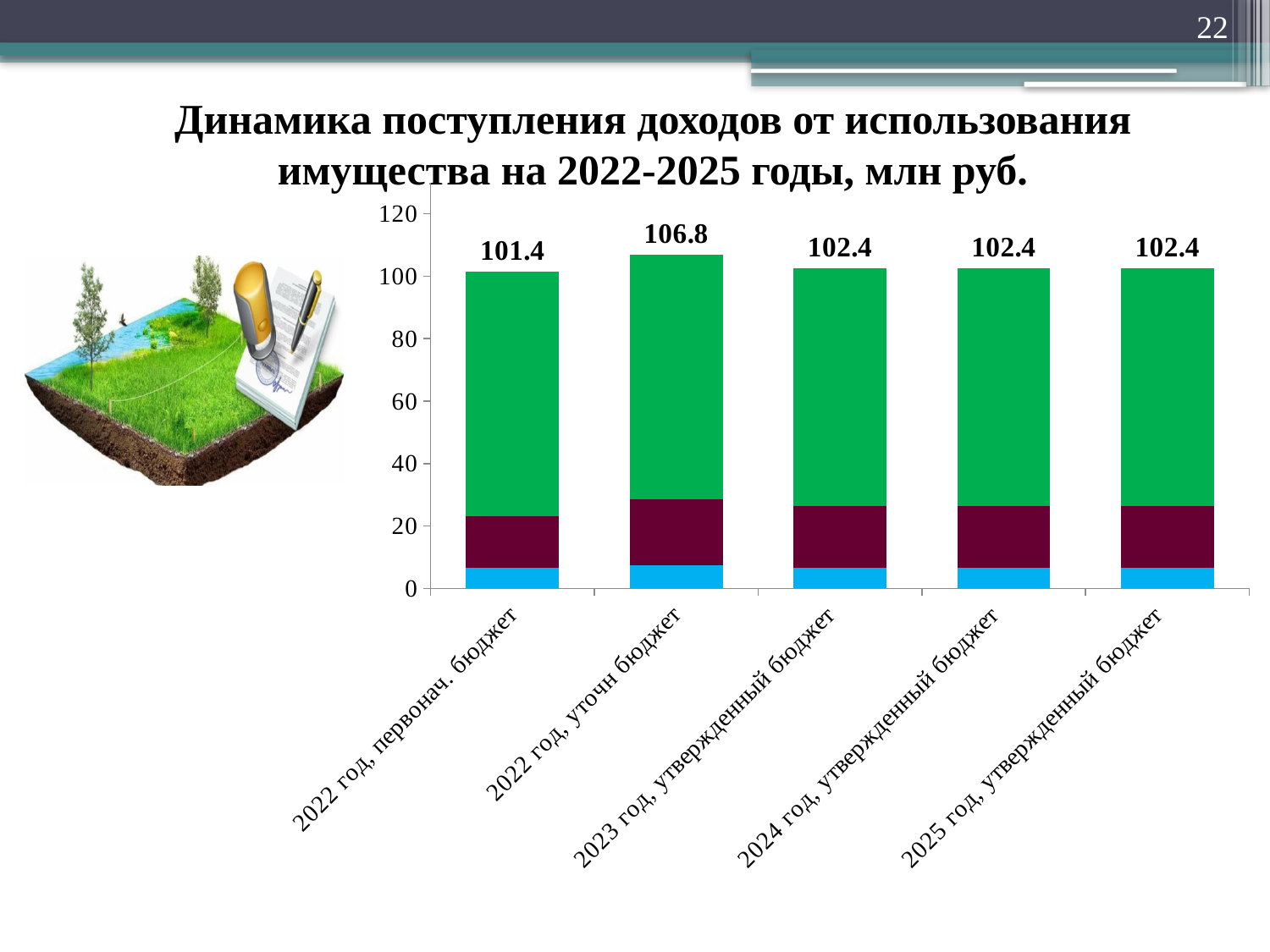
What is the total value shown for the bar labelled "2022 год, уточн бюджет"? 106.8 How many coloured segments does each bar consist of? 3 Is the total value for "2025 год, утвержденный бюджет" greater or less than 100? greater Which is larger: the total for "2022 год, уточн бюджет" or the total for "2023 год, утвержденный бюджет"? 2022 год, уточн бюджет Which category has the highest total value? 2022 год, уточн бюджет Which category has the lowest total value? 2022 год, первонач. бюджет Do the total values for 2023, 2024 and 2025 (утвержденный бюджет) rise, fall, or stay the same across those years? Stay the same What is the difference between the total for "2022 год, уточн бюджет" and the total for "2022 год, первонач. бюджет"? 5.4 How many categories (bars) are shown on the chart? 5 What is the total value shown for the bar labelled "2024 год, утвержденный бюджет"? 102.4 What kind of chart is shown on the slide? Stacked bar chart What is the total value shown for the bar labelled "2022 год, первонач. бюджет"? 101.4